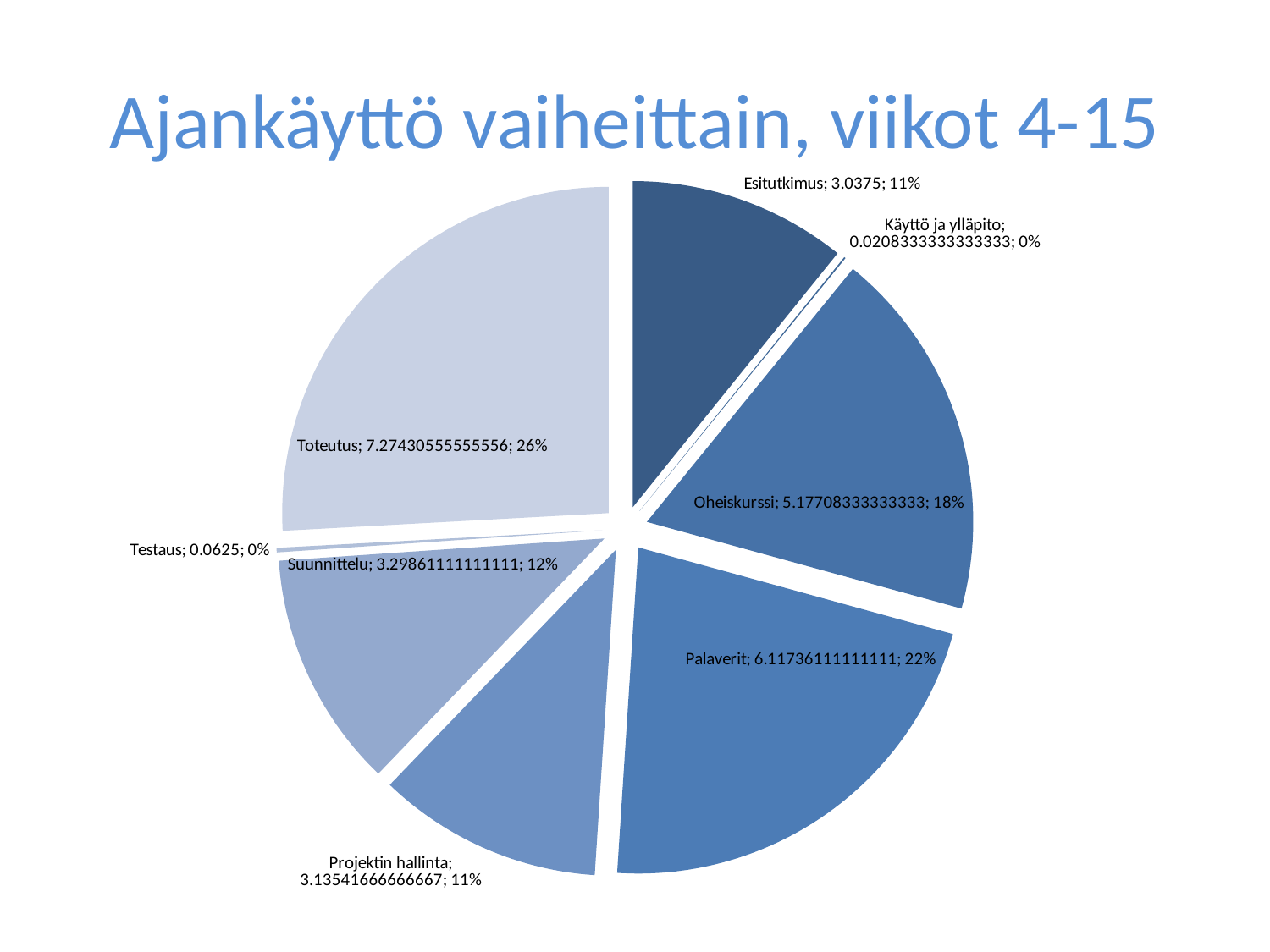
What is the value shown for Testaus? 0.0625 What is the title of the chart? Ajankäyttö vaiheittain, viikot 4-15 Which is larger, the value for Oheiskurssi or the value for Palaverit? Palaverit What is the value shown for Oheiskurssi? 5.17708333333333 How many slices does the pie chart have? 8 What is the value shown for Toteutus? 7.27430555555556 Which category has the largest slice of the pie? Toteutus Which category has the smallest value in the pie chart? Käyttö ja ylläpito What share of the pie does Suunnittelu represent? 12% What kind of chart is shown on the slide? Pie chart What share of the pie does Palaverit represent? 22% By how many percentage points does the share of Toteutus exceed the share of Palaverit? 4 percentage points